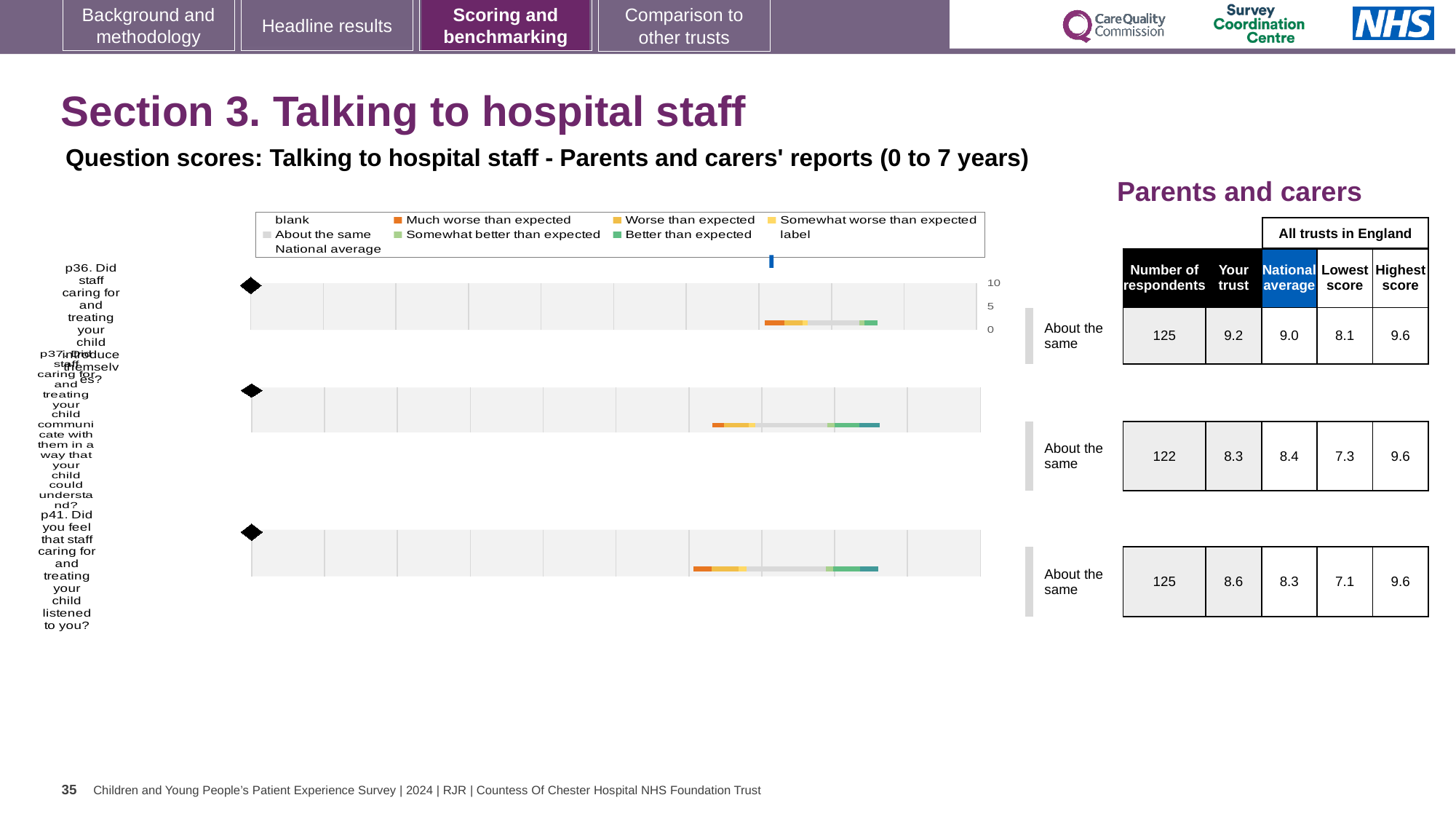
What kind of chart is used to show the question scores on this slide? bar chart How many entries does the legend above the charts list? 9 For question p41, which is larger: the 'Your trust' score or the National average? Your trust For question p41, what is the number of respondents? 125 What benchmark category is shown for all three questions? About the same For question p36, what is the Highest score among all trusts in England? 9.6 Which question has the highest 'Your trust' score? p36 Which question has the lowest 'Your trust' score? p37 For question p37, what is the National average score? 8.4 How many questions (charts) are shown on the slide? 3 For question p36, what is the 'Your trust' score? 9.2 For question p36, what is the difference between the 'Your trust' score and the National average? 0.2